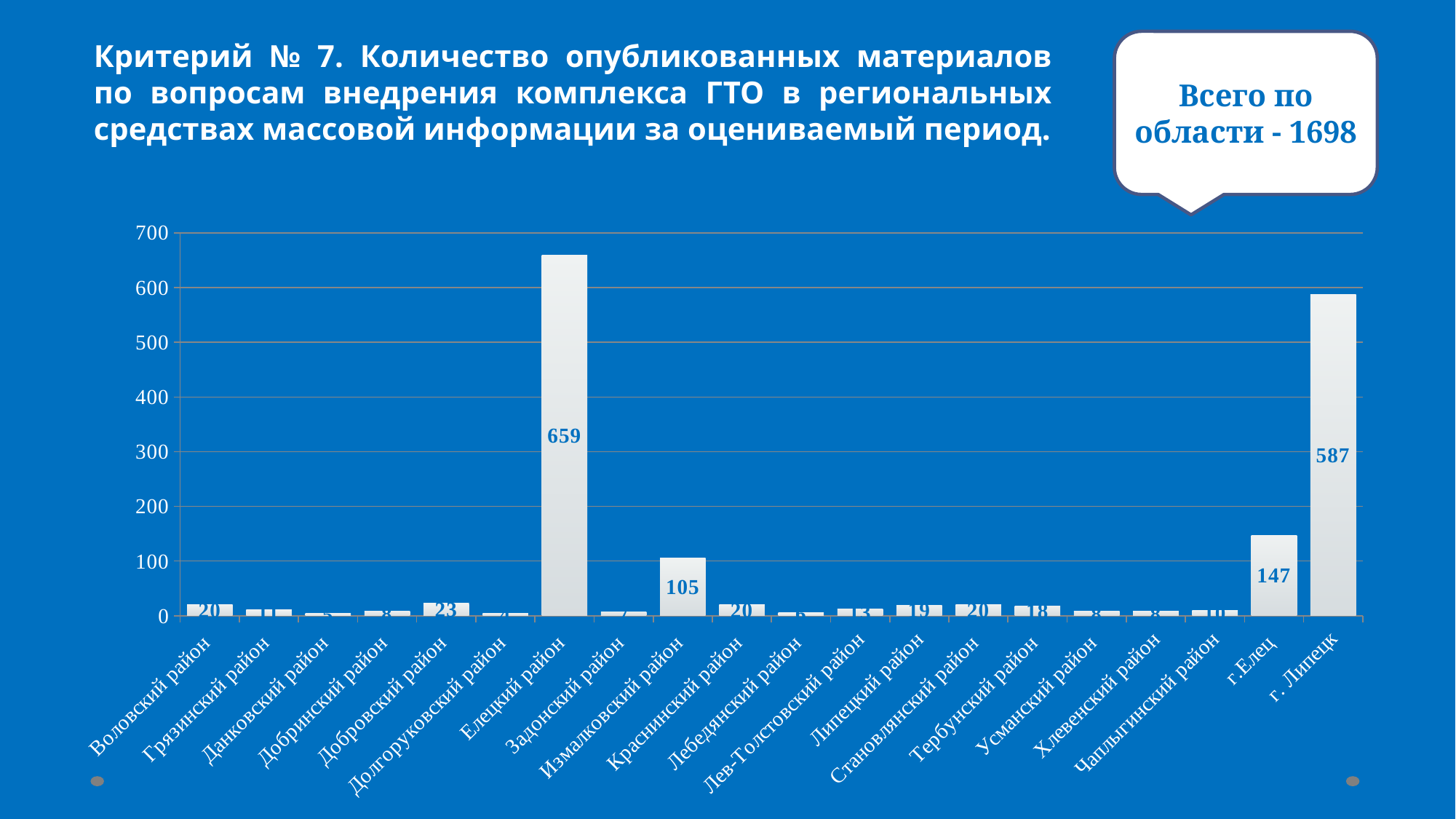
What is the value for Елецкий район? 659 What is the value for г.Елец? 147 Which is larger, the value for г.Елец or the value for Измалковский район? г.Елец How many categories are shown on the x axis? 20 What is the value for г. Липецк? 587 What is the difference between the values for Елецкий район and г. Липецк? 72 What is the value for Добровский район? 23 What is the difference between the values for г.Елец and Измалковский район? 42 Is the value for г. Липецк greater or less than 500? greater What is the value for Измалковский район? 105 Which category has the highest value? Елецкий район What kind of chart is shown on the slide? bar chart